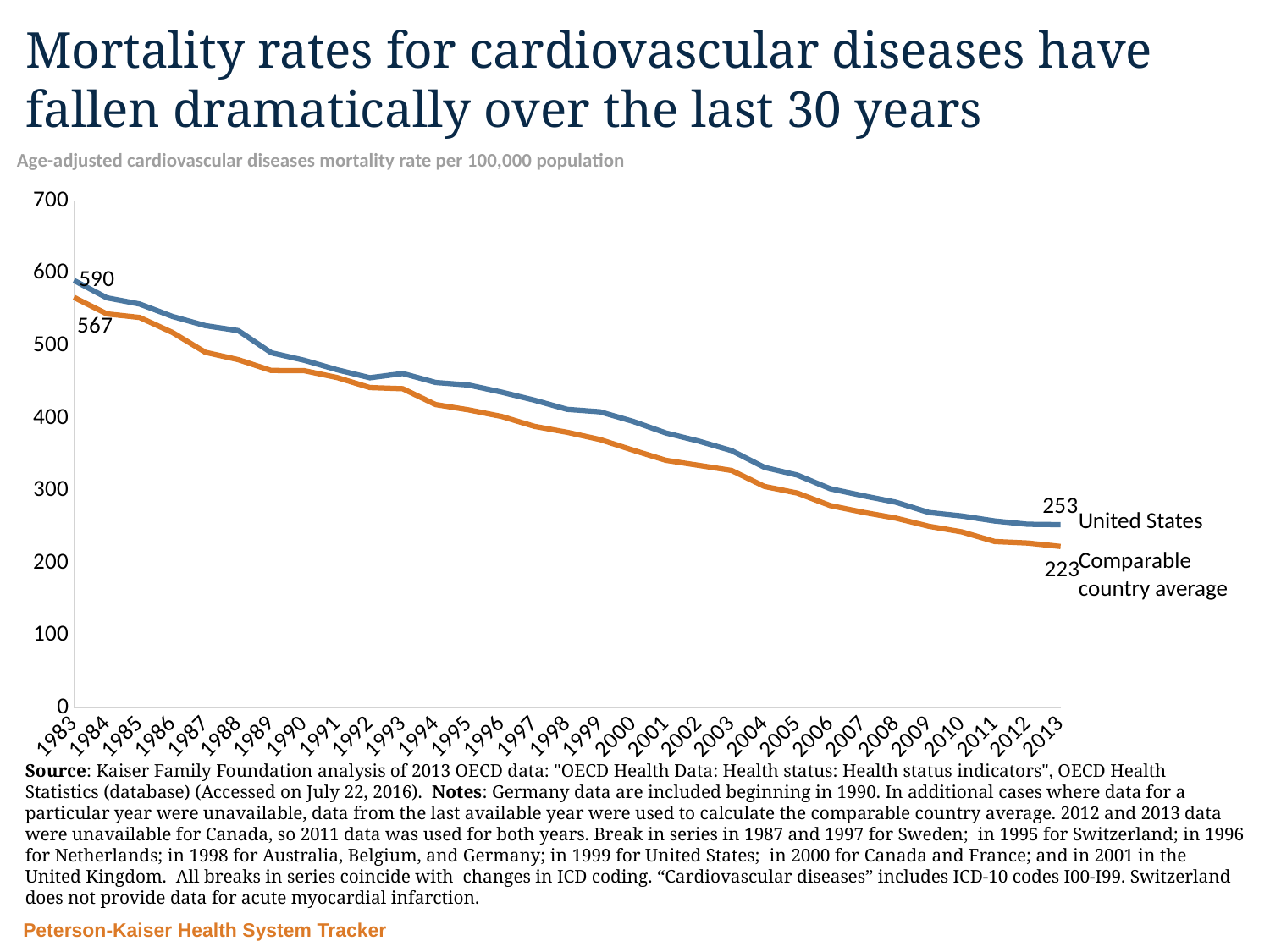
What was the United States cardiovascular disease mortality rate in 2013? 253 What kind of chart is shown on the slide? Line chart How many series are plotted on the chart? 2 In 1983, which was higher: the United States rate or the comparable country average? United States What was the comparable country average cardiovascular disease mortality rate in 2013? 223 Is the comparable country average in 2010 greater or less than 300? less By how much did the United States cardiovascular disease mortality rate fall between 1983 and 2013? 337 What was the comparable country average cardiovascular disease mortality rate in 1983? 567 Is the United States cardiovascular mortality rate in 2000 greater or less than 300? greater Do the cardiovascular mortality rates rise or fall from 1983 to 2013? Fall What was the age-adjusted cardiovascular disease mortality rate for the United States in 1983? 590 What is the difference between the United States rate and the comparable country average in 2013? 30